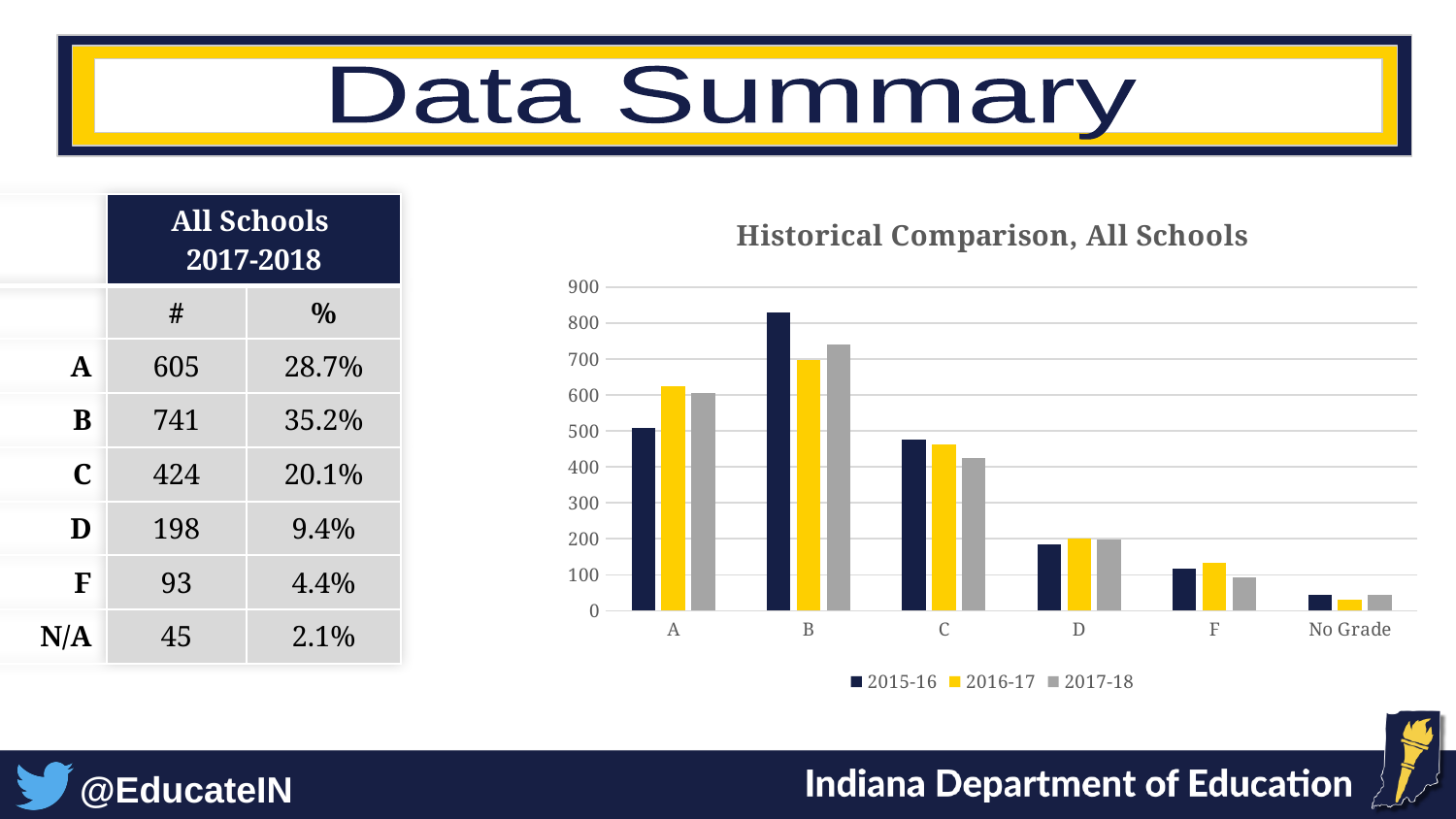
What kind of chart is shown on the slide? bar chart For grade A, which is larger: the 2015-16 value or the 2016-17 value? 2016-17 Is the 2016-17 value for No Grade greater or less than 100? less Is the 2015-16 value for grade B greater or less than 700? greater How many grade categories are shown on the x axis of the chart? 6 Is the 2017-18 value for grade C greater or less than 500? less Which grade category has the lowest value for the 2017-18 series? No Grade How many series does the chart's legend list? 3 What is the title of the chart? Historical Comparison, All Schools Which grade category has the highest value for the 2015-16 series? B For grade B, which is larger: the 2015-16 value or the 2017-18 value? 2015-16 Do the 2017-18 values rise or fall moving from grade B to No Grade along the x axis? fall